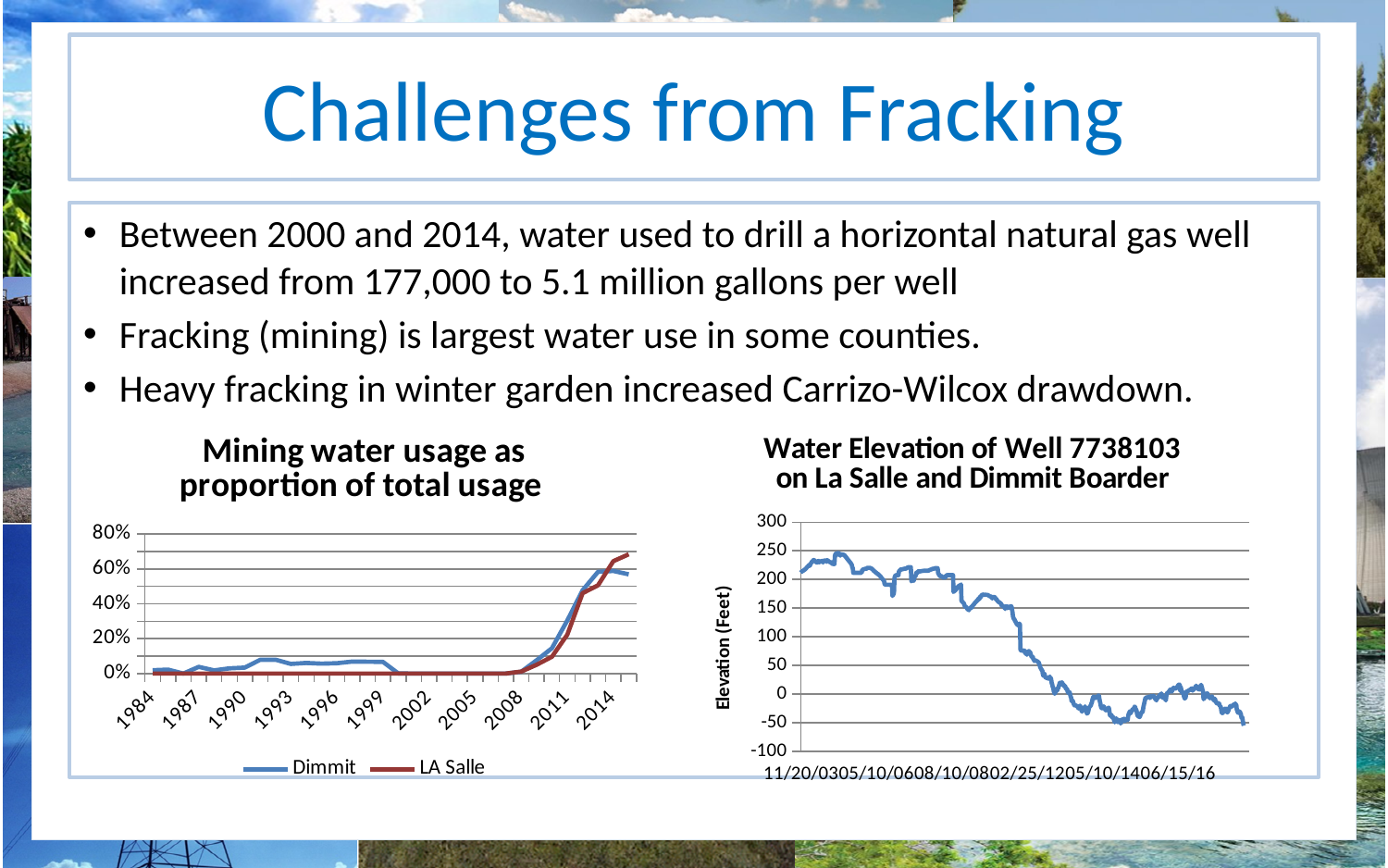
How many series does the legend of the 'Mining water usage as proportion of total usage' chart list? 2 In the 'Mining water usage as proportion of total usage' chart, which two series are shown in the legend? Dimmit and LA Salle What is the y-axis label of the 'Water Elevation of Well 7738103' chart? Elevation (Feet) In the 'Mining water usage as proportion of total usage' chart, is the Dimmit value for 2014 greater or less than 40%? greater What kind of chart is the 'Water Elevation of Well 7738103' chart? line chart In the 'Mining water usage as proportion of total usage' chart, do the values rise or fall between 2008 and 2014? rise In the 'Mining water usage as proportion of total usage' chart, which series is higher at the final year, Dimmit or LA Salle? LA Salle What kind of chart is the 'Mining water usage as proportion of total usage' chart? line chart In the 'Mining water usage as proportion of total usage' chart, is the LA Salle value for 2005 greater or less than 20%? less In the 'Water Elevation of Well 7738103' chart, is the elevation at the start of the series greater or less than 200? greater In the 'Water Elevation of Well 7738103' chart, does the elevation rise or fall overall from left to right? fall